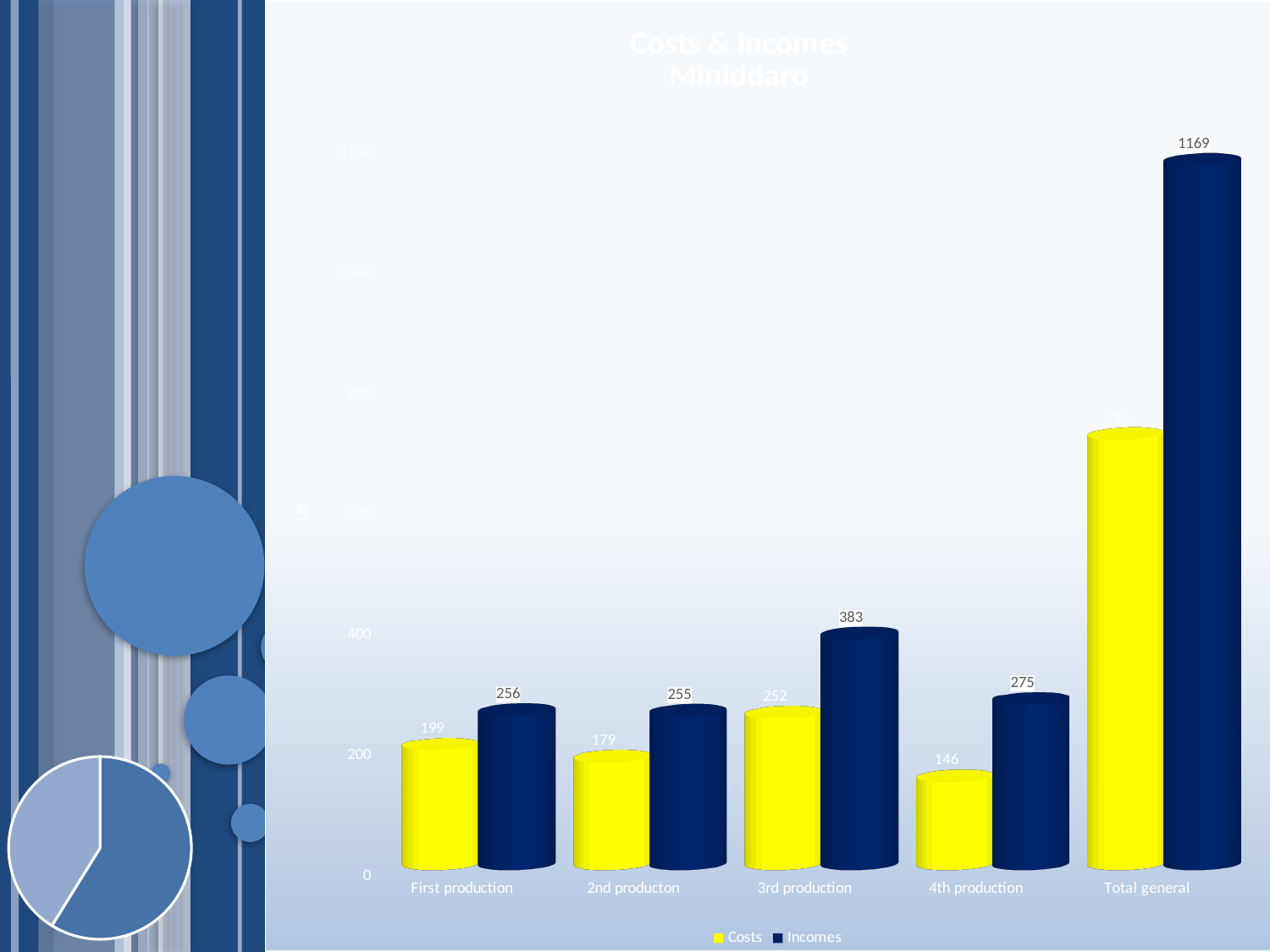
For First production, which is larger: Costs or Incomes? Incomes How many categories are shown on the x axis? 5 Is the Costs value for Total general greater or less than 600? greater Which category has the lowest Costs value? 4th production What is the Incomes value for 3rd production? 383 How many series does the legend list? 2 Which category has the highest Incomes value? Total general What is the difference between Incomes and Costs for 3rd production? 131 What is the Costs value for First production? 199 What is the Incomes value for Total general? 1169 What kind of chart is shown on the slide? bar chart What is the Costs value for 4th production? 146